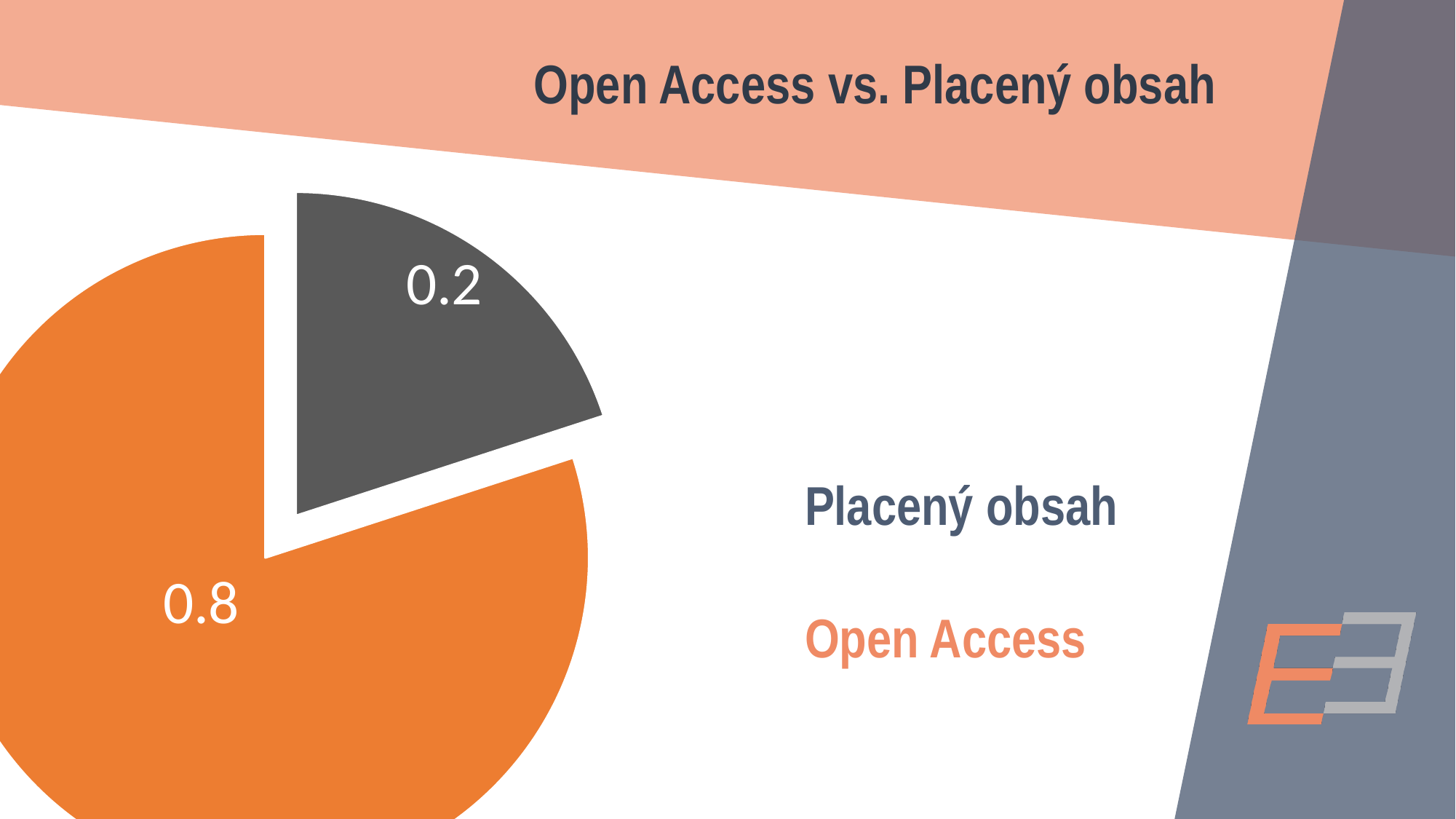
What is the value shown for the Open Access slice? 0.8 Which slice is the smallest? Placený obsah What colour is the Open Access slice? orange What is the difference between the Open Access value and the Placený obsah value? 0.6 Which is larger, Open Access or Placený obsah? Open Access What is the title of the chart? Open Access vs. Placený obsah Which slice is the largest? Open Access What kind of chart is shown on the slide? pie chart What is the value shown for the Placený obsah slice? 0.2 What is the total of the two slice values? 1.0 How many slices does the pie chart have? 2